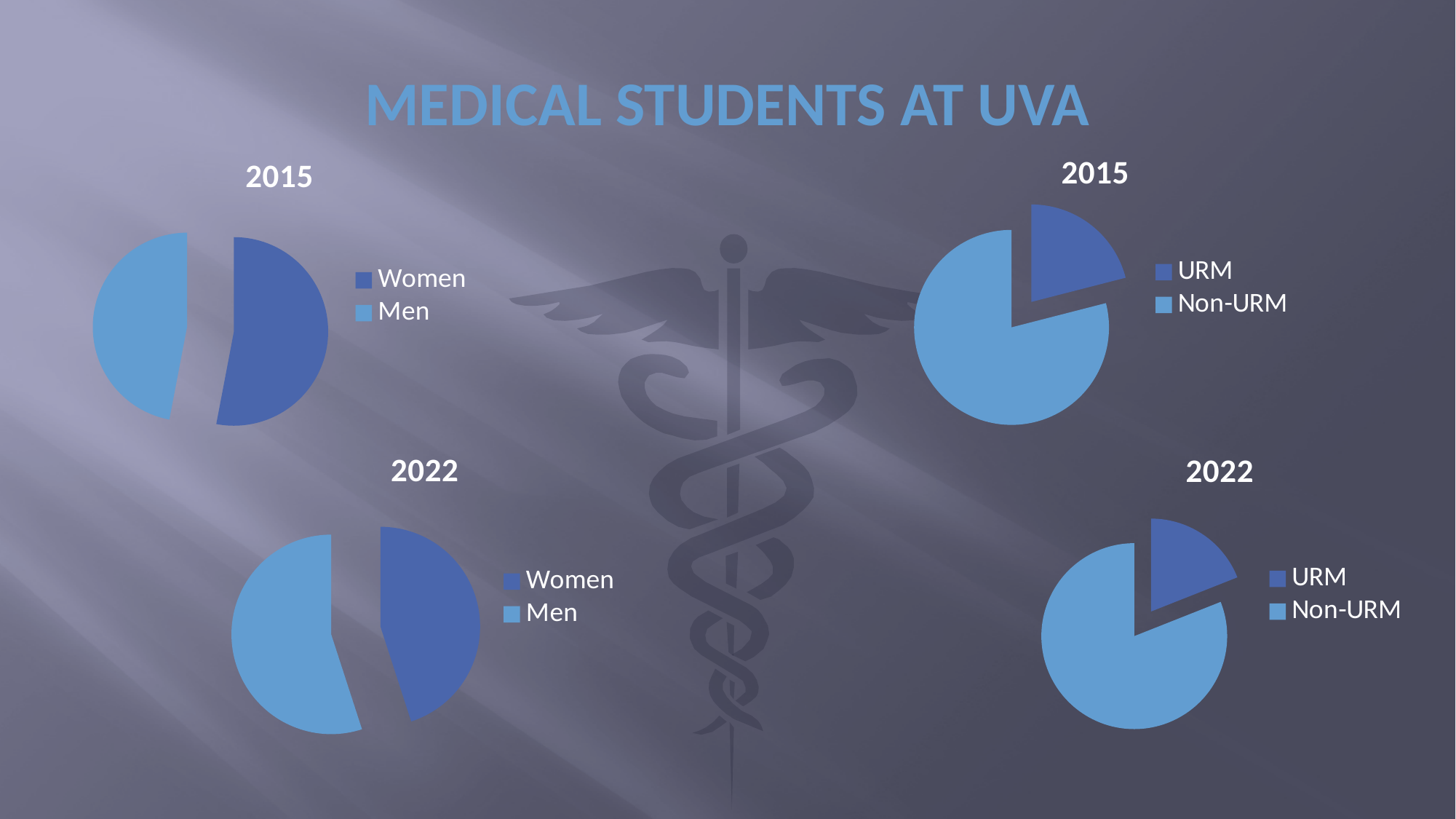
In the bottom-right 2022 chart, which is larger, URM or Non-URM? Non-URM What kind of chart is the top-left chart titled 2015? pie chart In the top-right 2015 chart, which slice is the largest? Non-URM What is the title of the slide? MEDICAL STUDENTS AT UVA How many series does the legend of the top-left 2015 chart list? 2 How many series does the legend of the top-right 2015 chart list? 2 What kind of chart is the bottom-right chart titled 2022? pie chart In the bottom-right 2022 chart, which slice is the smallest? URM In the top-right 2015 chart, which is larger, URM or Non-URM? Non-URM What are the two legend entries of the bottom-left 2022 chart? Women, Men How many pie charts are shown on the slide? 4 How many slices does the bottom-left 2022 chart have? 2